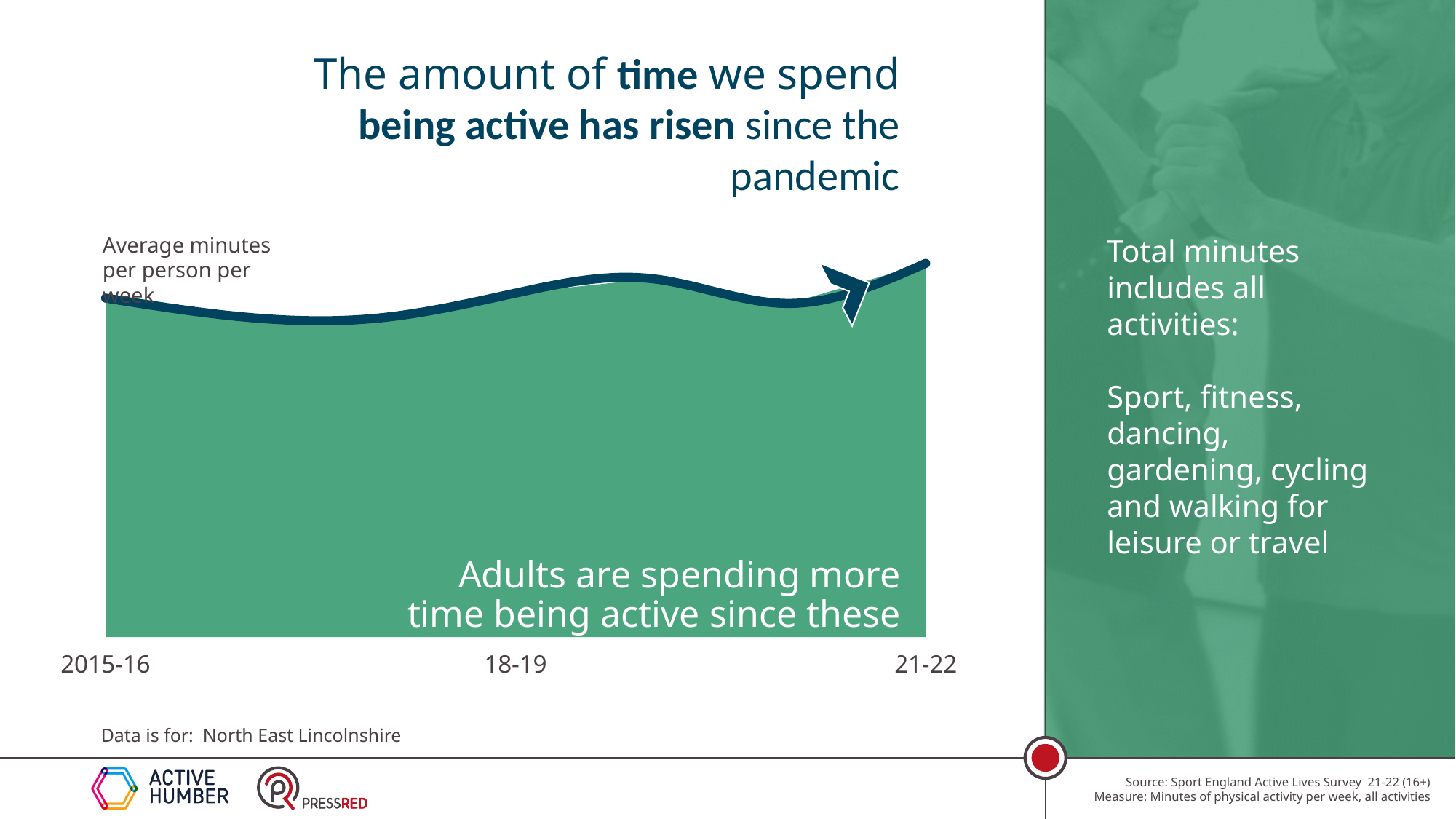
Is the value for 18-19 higher or lower than the value for 2015-16? Higher Does the line dip or keep rising immediately after 18-19 before reaching 21-22? Dip Which area does the chart's data cover? North East Lincolnshire What kind of chart is shown on the slide? Area chart What is the title of the chart on the slide? The amount of time we spend being active has risen since the pandemic What does the vertical axis of the chart measure? Average minutes per person per week Which year label appears last on the x axis of the chart? 21-22 Is the value for 21-22 higher or lower than the value for 2015-16? Higher How many year labels are shown along the x axis of the chart? 3 Which year label appears first on the x axis of the chart? 2015-16 Overall, does the line rise or fall from 2015-16 to 21-22? Rise